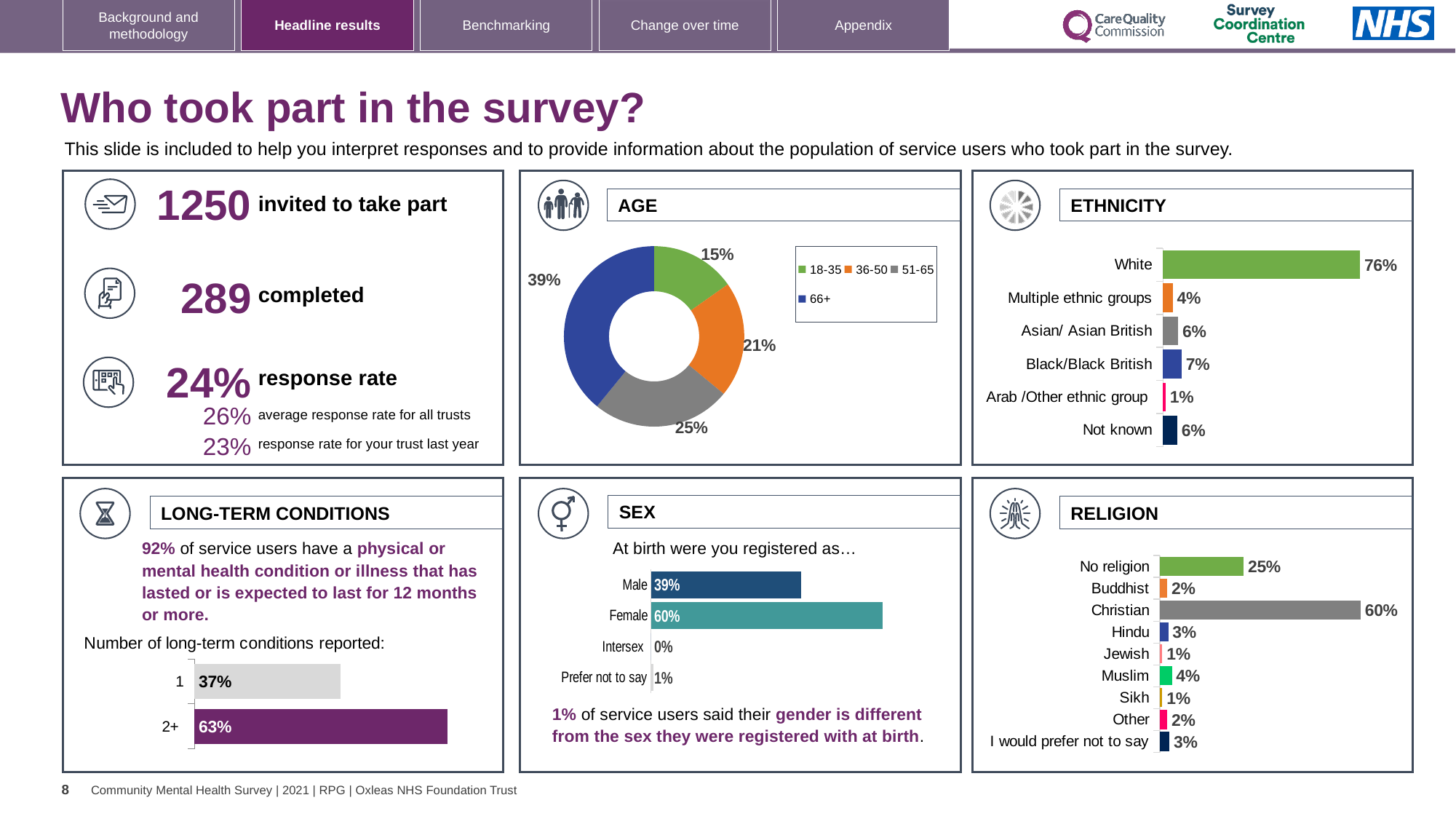
In the SEX chart, which is larger, Male or Female? Female In the AGE chart, which age group has the smallest share? 18-35 In the SEX chart, what is the value for Intersex? 0% In the AGE chart, what share of respondents are aged 66+? 39% How many categories are shown in the RELIGION chart? 9 In the ETHNICITY chart, what is the value for Black/Black British? 7% In the RELIGION chart, which category has the highest value? Christian In the ETHNICITY chart, which category has the highest value? White In the LONG-TERM CONDITIONS chart, what percentage reported 2+ conditions? 63% What kind of chart is the AGE chart? Donut chart How many age groups does the legend of the AGE chart list? 4 In the ETHNICITY chart, what is the difference between White and Asian/ Asian British? 70%